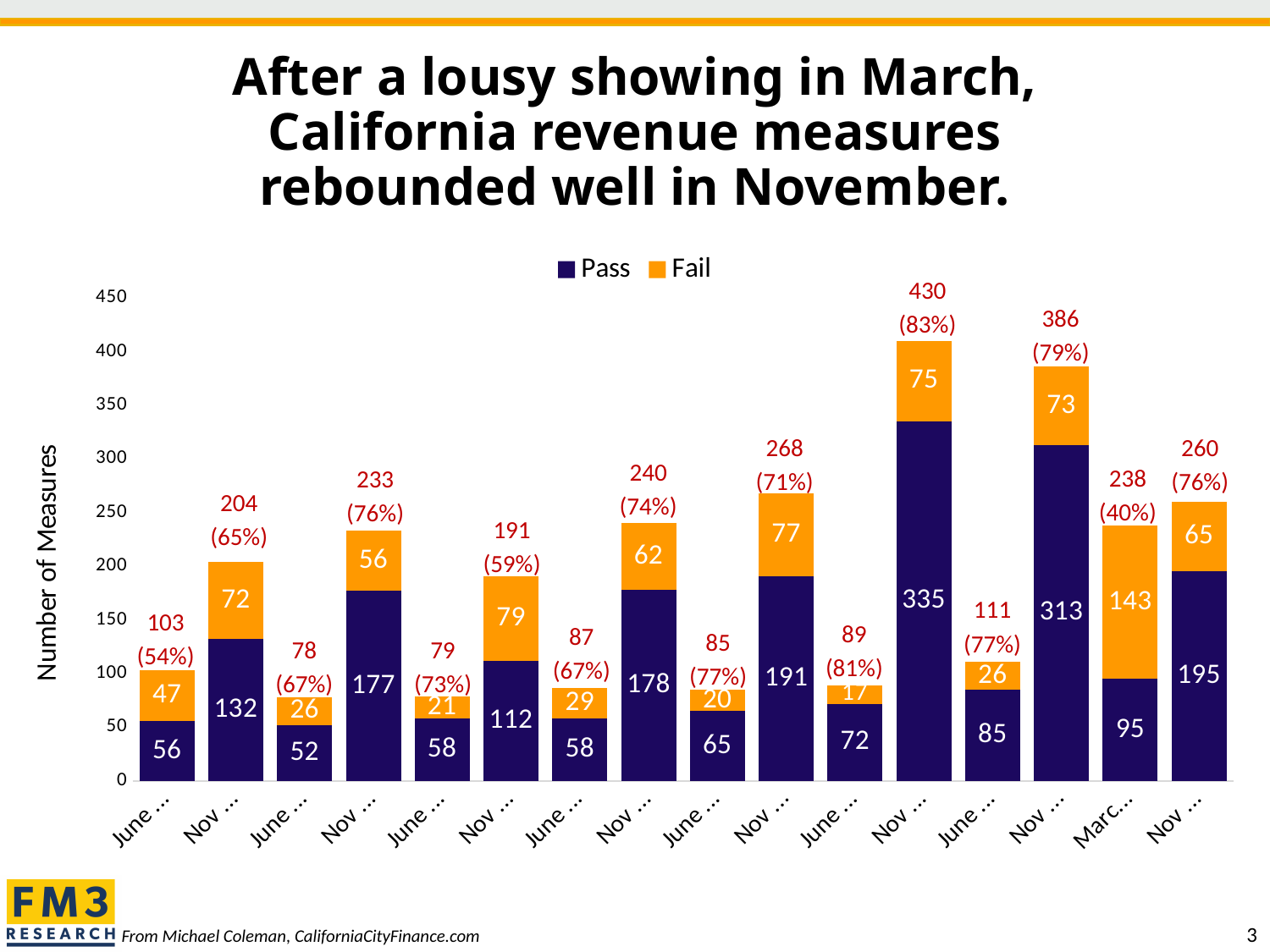
What is the difference between the Fail and Pass values for the bar labeled 'Marc...' (March)? 48 What is the Fail value for the bar labeled 'Marc...' (March)? 143 What is the total number of measures for the tallest bar? 430 What pass percentage is shown above the bar labeled 'Marc...' (March)? 40% For the bar labeled 'Marc...' (March), which is larger, the Pass segment or the Fail segment? Fail What is the Pass value for the first (leftmost) bar? 56 Which colour represents the Fail series in the legend? orange What is the Pass value for the bar labeled 'Marc...' (March)? 95 How many series does the legend list? 2 How many bars are plotted in the chart? 16 What is the total number of measures for the last (rightmost) bar? 260 What type of chart is shown on the slide? stacked bar chart